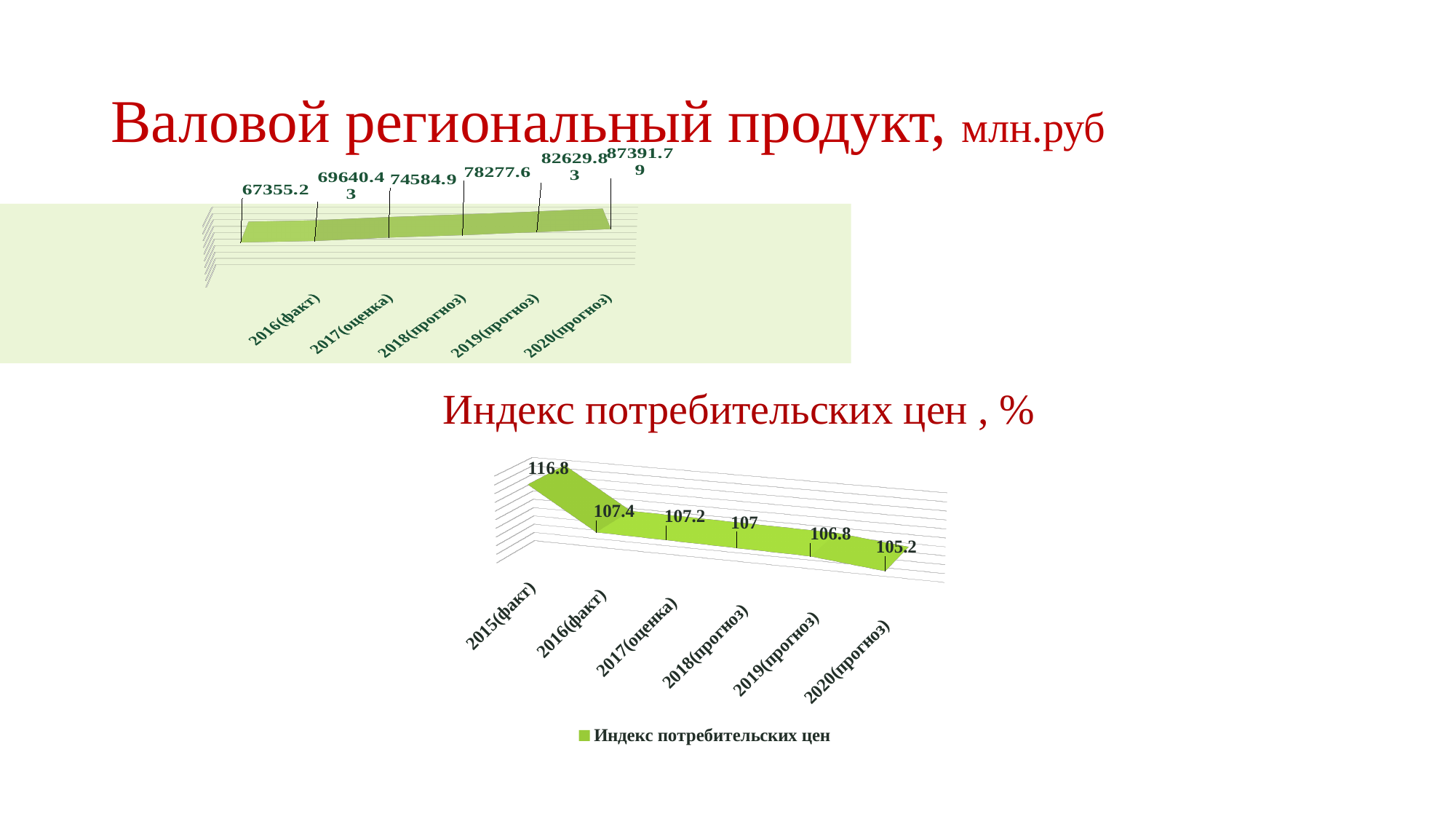
In the chart 'Индекс потребительских цен , %', how many series does the legend list? 1 In the chart 'Индекс потребительских цен , %', do the values rise or fall from left to right along the x axis? fall In the chart 'Индекс потребительских цен , %', what is the value for 2017(оценка)? 107.2 In the chart 'Индекс потребительских цен , %', what is the value for 2020(прогноз)? 105.2 In the chart 'Индекс потребительских цен , %', which category has the lowest value? 2020(прогноз) In the chart 'Индекс потребительских цен , %', which is larger: the value for 2018(прогноз) or 2019(прогноз)? 2018(прогноз) In the chart 'Валовой региональный продукт, млн.руб', do the values rise or fall from left to right along the x axis? rise In the chart 'Индекс потребительских цен , %', which category has the highest value? 2015(факт) In the chart 'Валовой региональный продукт, млн.руб', what is the highest data label value shown? 87391.79 In the chart 'Индекс потребительских цен , %', what is the difference between the values for 2015(факт) and 2016(факт)? 9.4 In the chart 'Индекс потребительских цен , %', what is the value for 2015(факт)? 116.8 In the chart 'Индекс потребительских цен , %', how many categories are shown on the x axis? 6